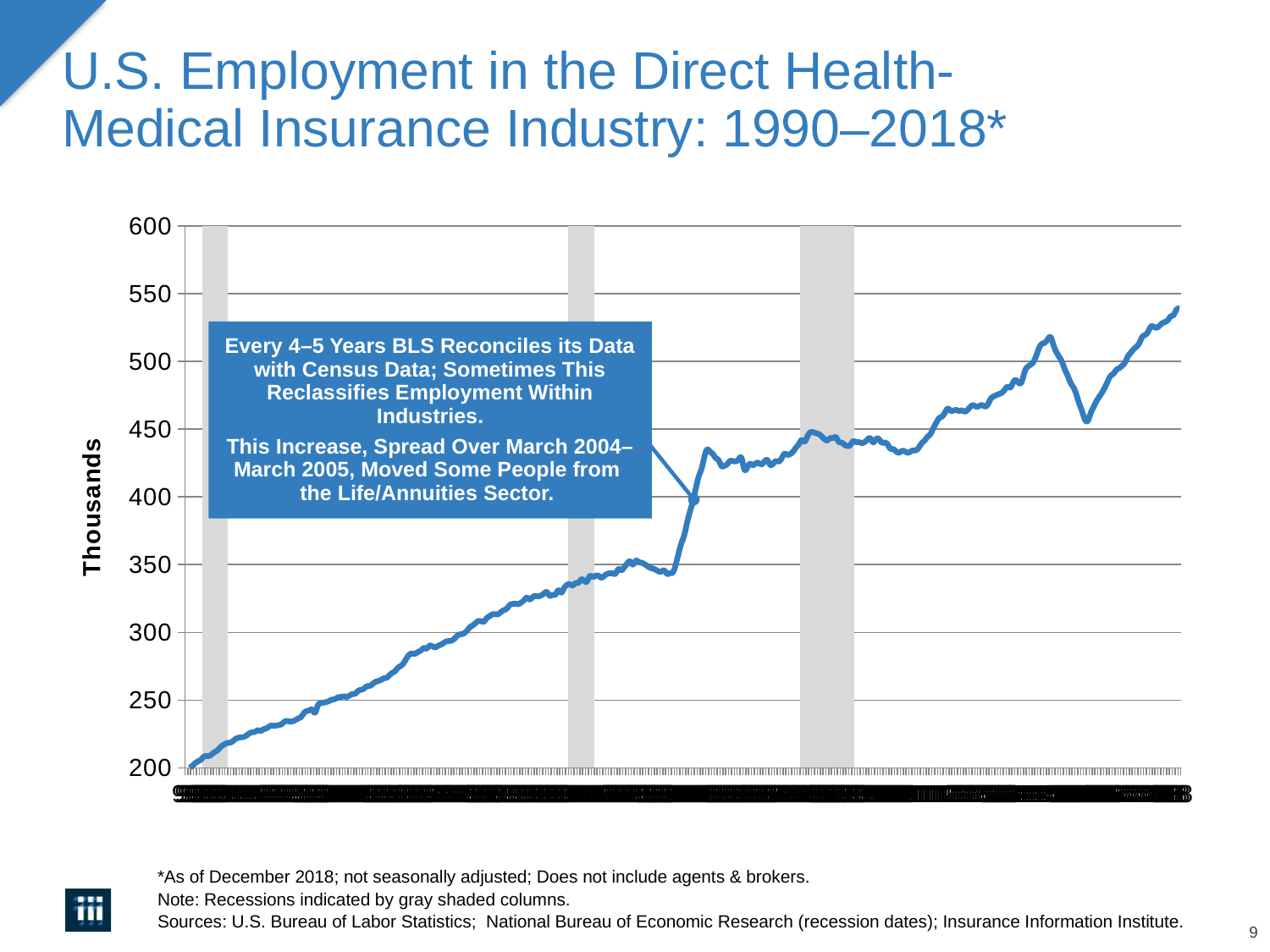
Is the value at the right end of the line (December 2018) greater or less than 500? greater At which end of the x axis does the line reach its lowest value? the left end (1990) At which end of the x axis does the line reach its highest value? the right end (2018) Is the value at the right end of the line (December 2018) greater or less than 550? less Is the value at the left end of the line (1990) greater or less than 250? less What kind of chart is shown on the slide? line chart Overall, do the values on the chart rise or fall from left to right along the x axis? rise What is the label on the vertical axis of the chart? Thousands How many gray shaded recession columns appear on the chart? 3